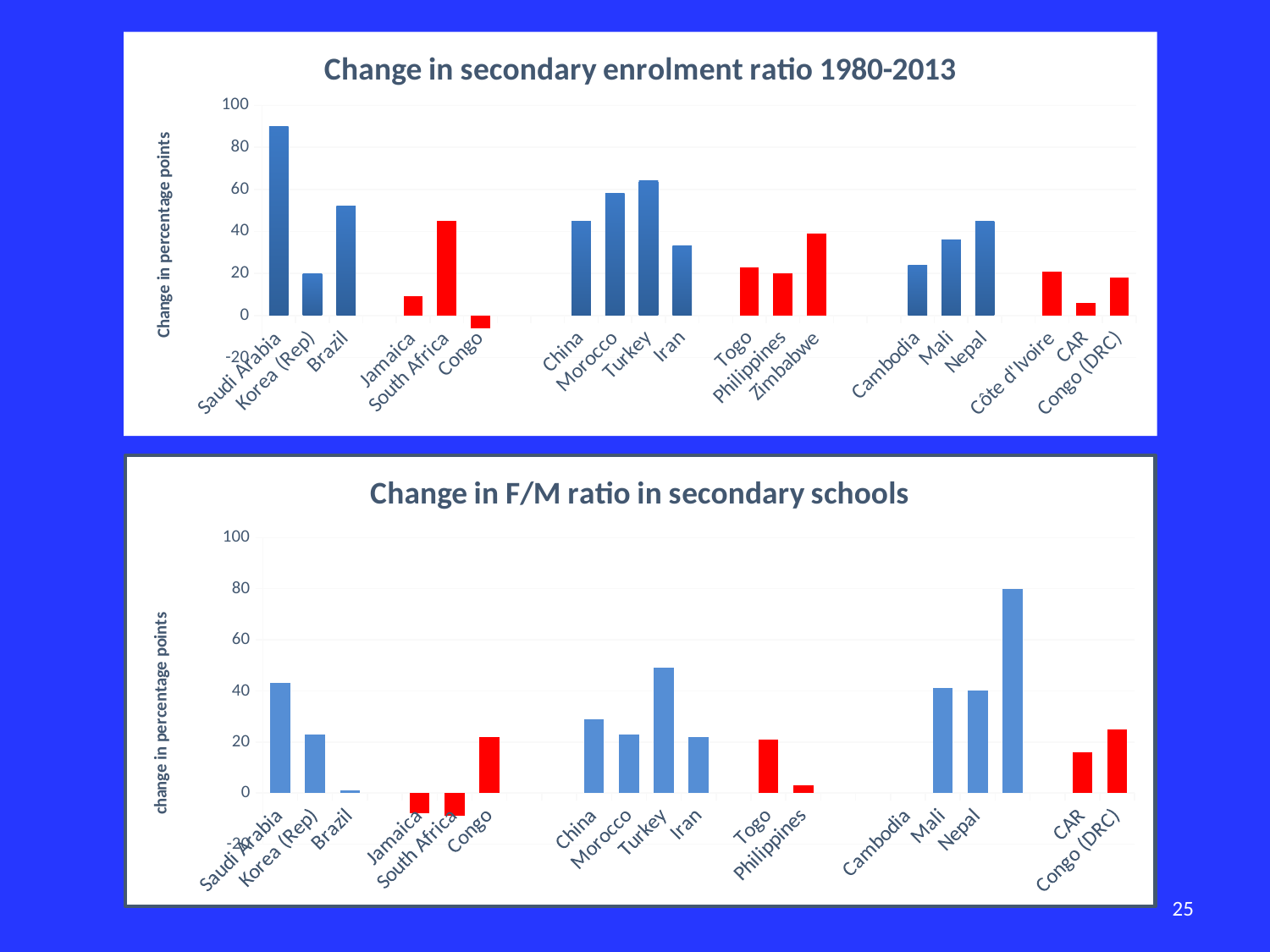
In the chart titled 'Change in secondary enrolment ratio 1980-2013', which country has the lowest value? Congo In the chart titled 'Change in F/M ratio in secondary schools', which is larger, the value for Saudi Arabia or the value for Korea (Rep)? Saudi Arabia In the chart titled 'Change in secondary enrolment ratio 1980-2013', is the value for Congo greater or less than 0? less In the chart titled 'Change in secondary enrolment ratio 1980-2013', is the value for Morocco greater or less than 40? greater In the chart titled 'Change in F/M ratio in secondary schools', is the value for Turkey greater or less than 40? greater In the chart titled 'Change in secondary enrolment ratio 1980-2013', what is the label on the vertical axis? Change in percentage points In the chart titled 'Change in secondary enrolment ratio 1980-2013', how many countries are shown on the x axis? 19 In the chart titled 'Change in secondary enrolment ratio 1980-2013', which country has the highest value? Saudi Arabia In the chart titled 'Change in secondary enrolment ratio 1980-2013', which is larger, the value for Brazil or the value for Korea (Rep)? Brazil In the chart titled 'Change in secondary enrolment ratio 1980-2013', what kind of chart is shown? bar chart In the chart titled 'Change in secondary enrolment ratio 1980-2013', which is larger, the value for Turkey or the value for Iran? Turkey